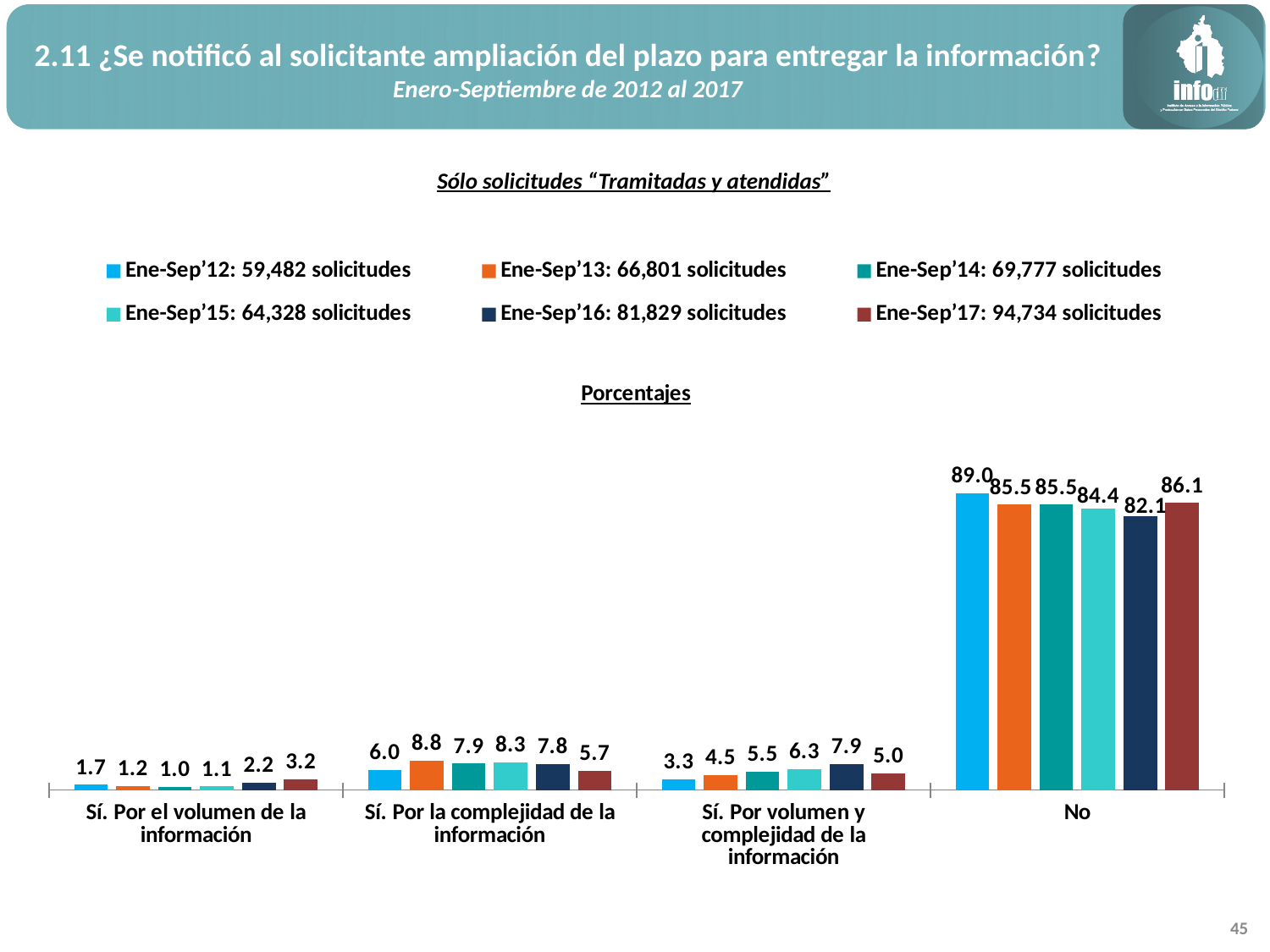
Which series has the highest value in the "No" category? Ene-Sep'12 According to the legend, how many solicitudes does the Ene-Sep'17 series represent? 94,734 solicitudes What is the value for Ene-Sep'17 in the "No" category? 86.1 What kind of chart is shown on the slide? Bar chart How many series does the legend list? 6 In the "Sí. Por la complejidad de la información" category, which is larger: the Ene-Sep'13 value or the Ene-Sep'17 value? Ene-Sep'13 What is the value for Ene-Sep'13 in the "Sí. Por la complejidad de la información" category? 8.8 How many categories are shown on the x axis of the chart? 4 Do the values for the "Sí. Por el volumen de la información" category rise or fall from Ene-Sep'14 to Ene-Sep'17? Rise Which series has the lowest value in the "Sí. Por el volumen de la información" category? Ene-Sep'14 What is the value for Ene-Sep'16 in the "Sí. Por volumen y complejidad de la información" category? 7.9 What is the difference between the Ene-Sep'12 and Ene-Sep'16 values in the "No" category? 6.9